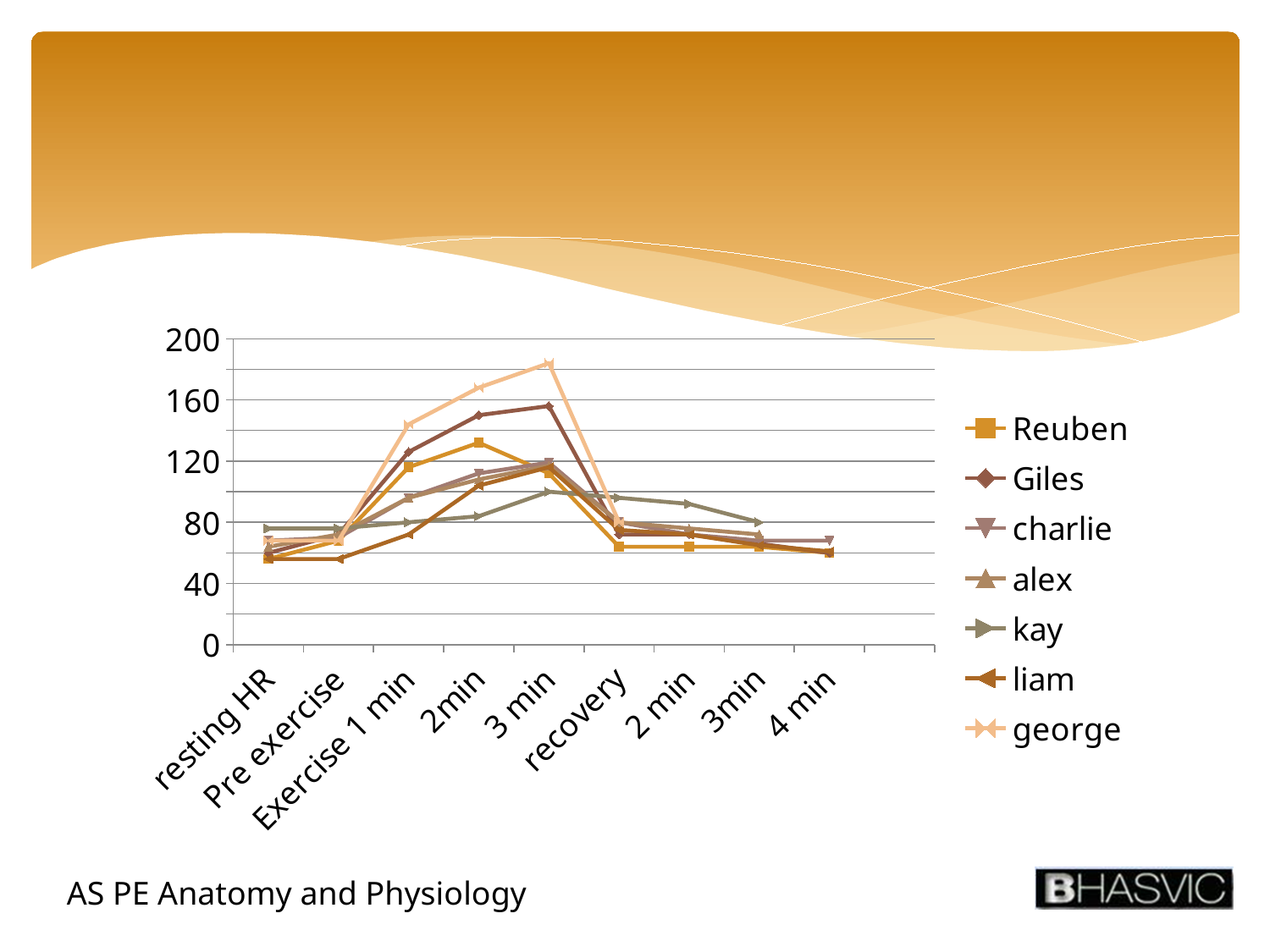
Which series has the highest value at 3 min (during exercise)? george Is the value for Reuben at recovery greater or less than 80? less Is the value for george at 3 min (during exercise) greater or less than 160? greater Which series has the lowest value at 3 min (during exercise)? kay What kind of chart is shown on the slide? line chart Do the values for george rise or fall from resting HR to 3 min (during exercise)? rise At 3 min (during exercise), which is larger: george or Giles? george Which series is listed first in the legend? Reuben How many categories are shown along the x axis? 9 Which series has the highest value at recovery? kay How many series does the legend list? 7 Is the value for Giles at 2min (during exercise) greater or less than 120? greater